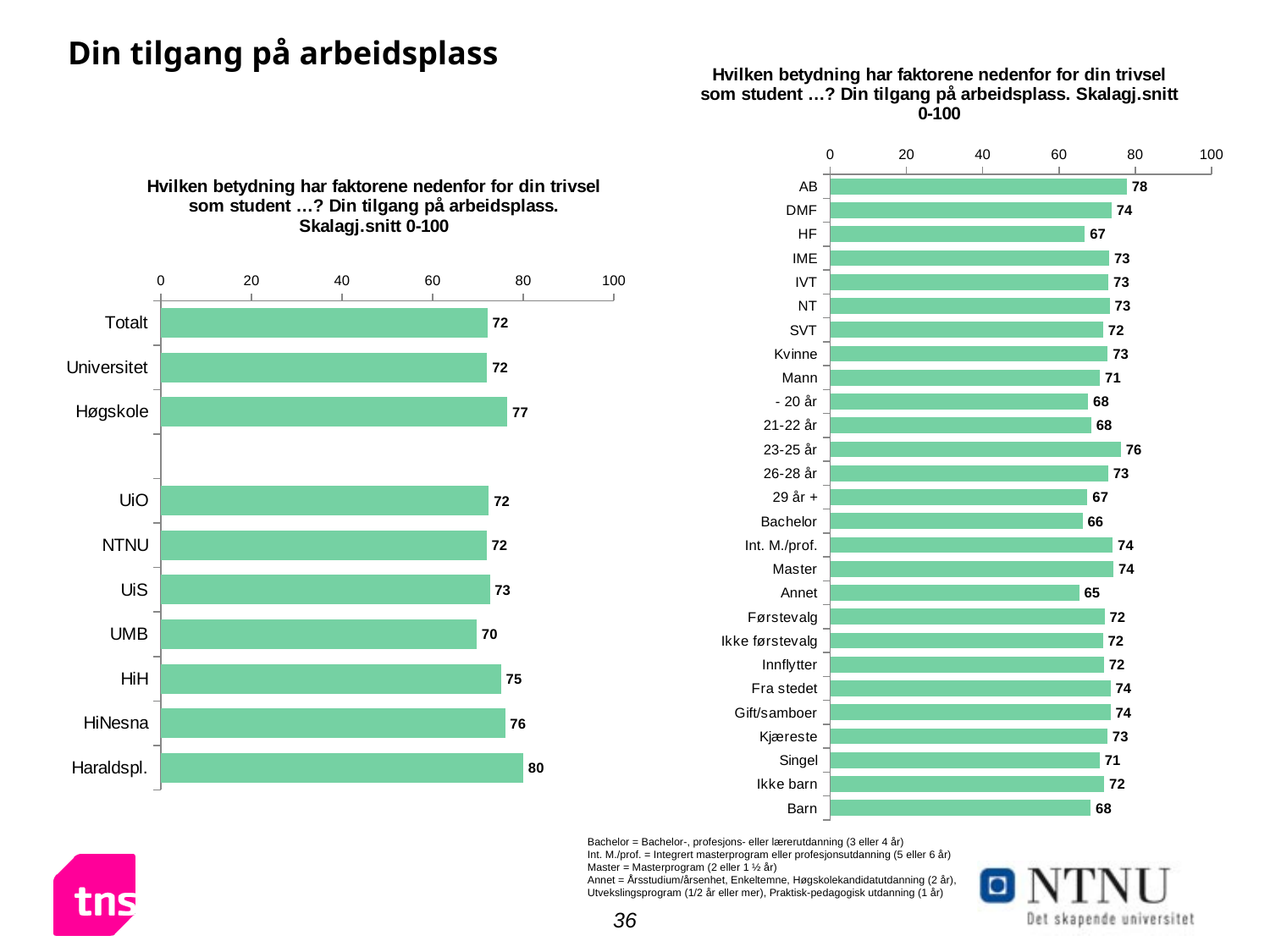
In the left chart, how many categories are plotted? 10 In the left chart, what is the difference between the values for Høgskole and Universitet? 5 In the right chart, is the value for Bachelor greater or less than 80? less What kind of chart is the left chart? bar chart In the left chart, what is the value for Haraldspl.? 80 In the right chart, which category has the lowest value? Annet In the right chart, what is the difference between the values for 23-25 år and 29 år +? 9 In the left chart, which category has the lowest value? UMB In the right chart, which category has the highest value? AB In the left chart, which category has the highest value? Haraldspl. In the left chart, which is larger, the value for HiH or the value for UiS? HiH In the right chart, what is the value for AB? 78